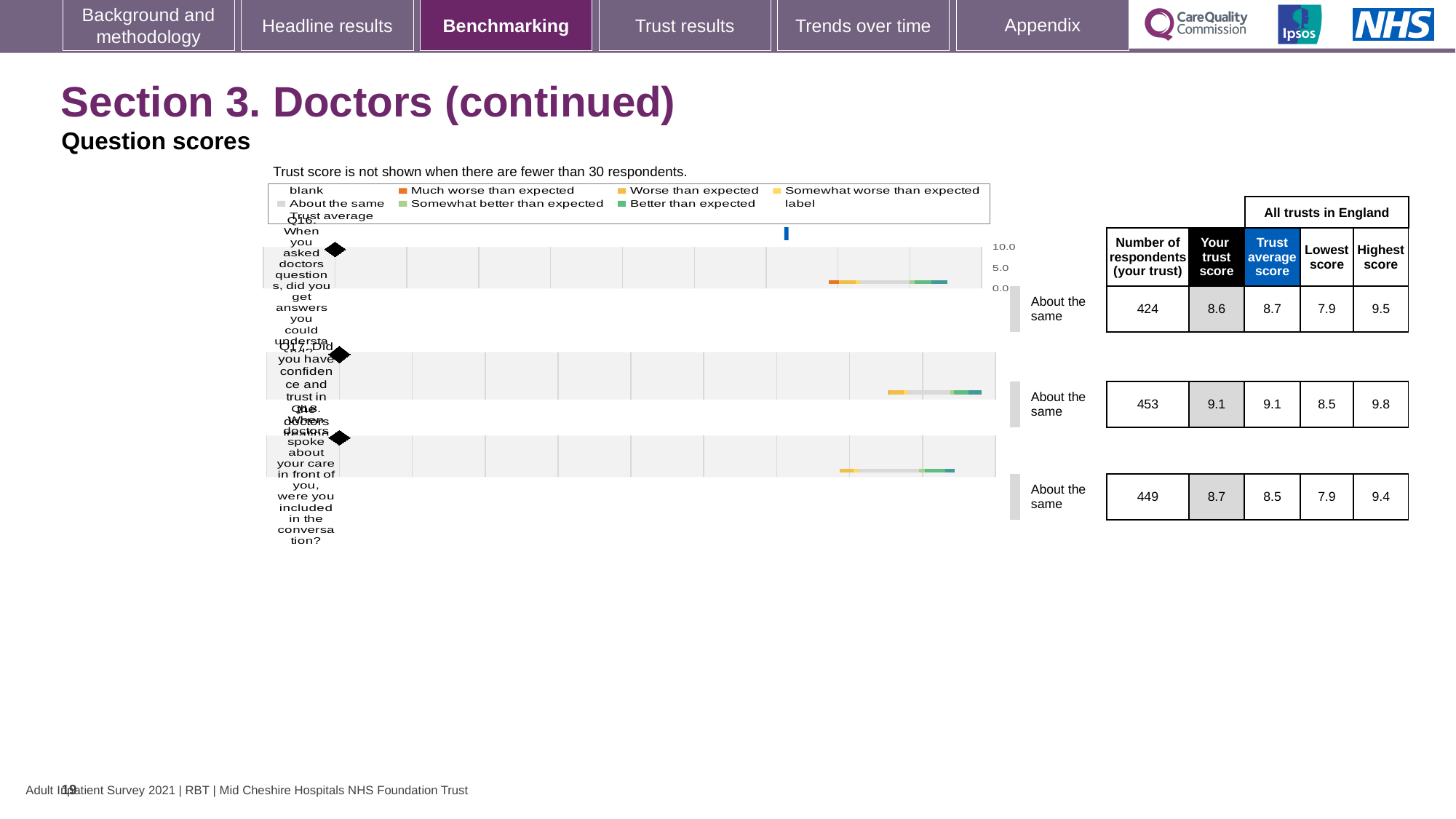
What kind of chart is used to show the question scores on this slide? bar chart What is the number of respondents for Q18 (When doctors spoke about your care in front of you, were you included in the conversation?)? 449 What is the trust score for Q17 (Did you have confidence and trust in the doctors treating you?)? 9.1 What is the trust score for Q16 (When you asked doctors questions, did you get answers you could understand?)? 8.6 Which question has the highest trust score? Q17 Which question has the lowest number of respondents? Q16 What is the difference between the trust score and the trust average score for Q18? 0.2 What is the lowest score across all trusts in England for Q16? 7.9 How many questions (categories) are plotted in the chart? 3 What is the highest score across all trusts in England for Q17? 9.8 What benchmark category is shown for all three questions? About the same Is the trust score for Q16 larger or smaller than the trust average score for Q16? smaller